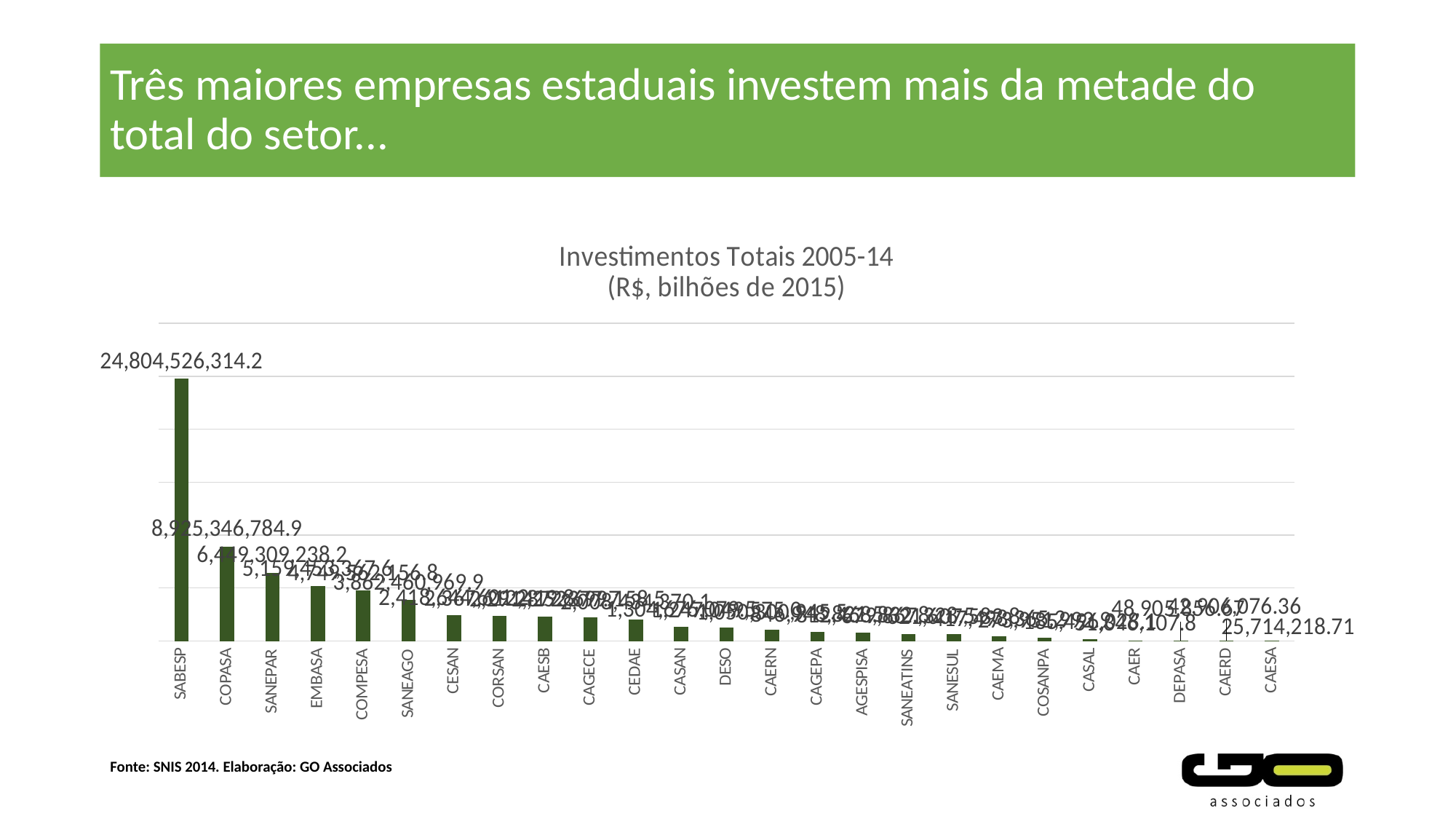
Which has a larger value, SANEPAR or CAESA? SANEPAR What is the value shown for SABESP? 24,804,526,314.2 Which has a larger value, COPASA or EMBASA? COPASA How many companies are shown on the x axis? 25 What type of chart is shown on the slide? Bar chart Which company has the lowest total investment? CAESA What is the value shown for CAESA? 25,714,218.71 What is the title of the chart? Investimentos Totais 2005-14 (R$, bilhões de 2015) Which company has the highest total investment? SABESP What is the difference between the values for SABESP and SANEPAR? 18,355,217,076.0 Do the values rise or fall from left to right along the x axis? Fall What is the value shown for SANEPAR? 6,449,309,238.2